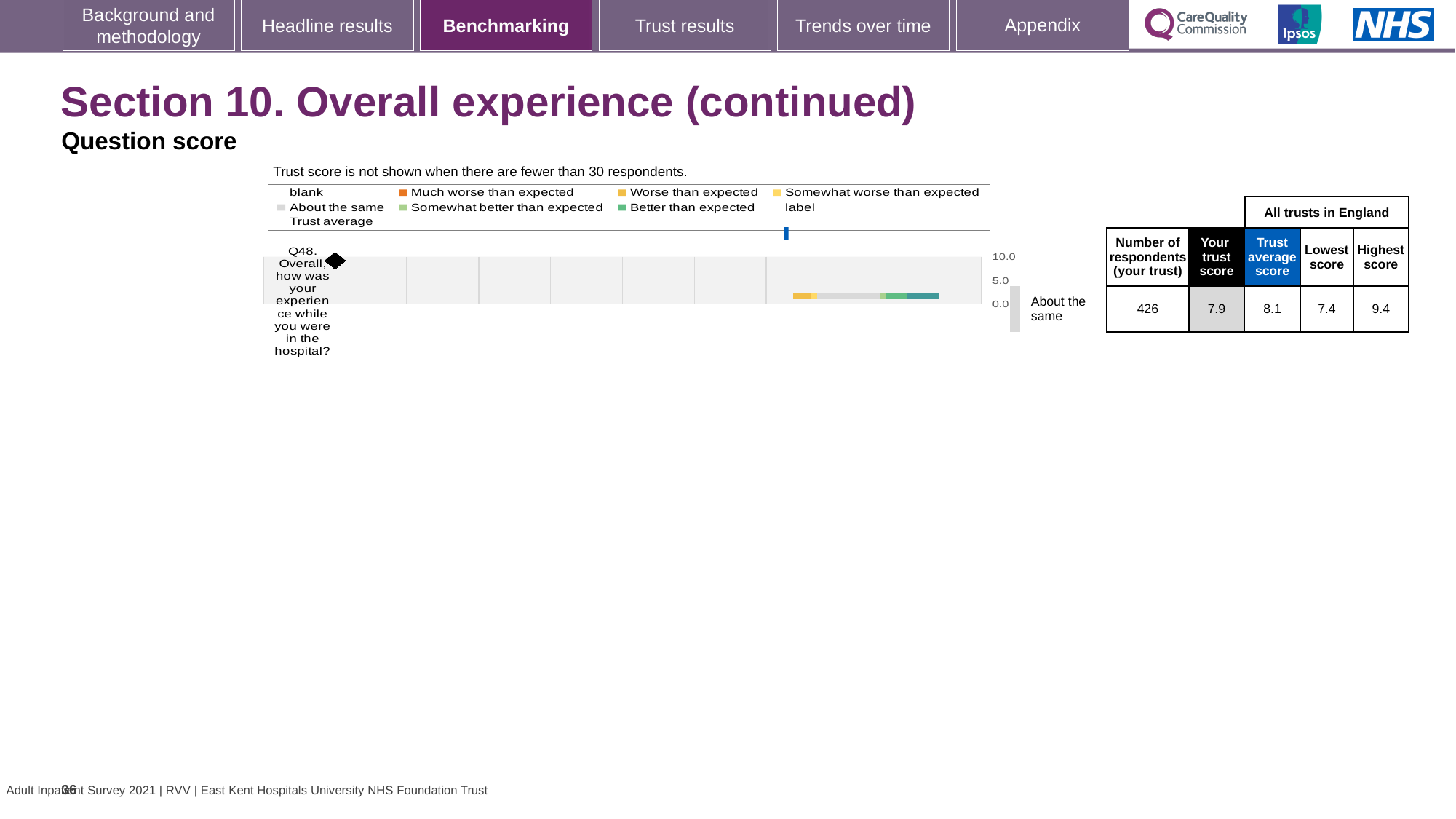
Is the trust score for Q48 greater or less than 5.0? greater How many questions are plotted in the chart? 1 What kind of chart is used to show the Q48 benchmarking result? Bar chart What is the highest score among all trusts in England for Q48? 9.4 What is the difference between the highest and lowest scores for Q48 across all trusts in England? 2.0 What is the trust score for Q48 shown on the slide? 7.9 What is the trust average score for Q48 across all trusts in England? 8.1 What is the lowest score among all trusts in England for Q48? 7.4 How many respondents from the trust answered Q48? 426 Which is larger for Q48: the trust score or the trust average score? Trust average score What is the difference between the trust average score and the trust score for Q48? 0.2 Which benchmarking category does the trust's Q48 result fall into? About the same